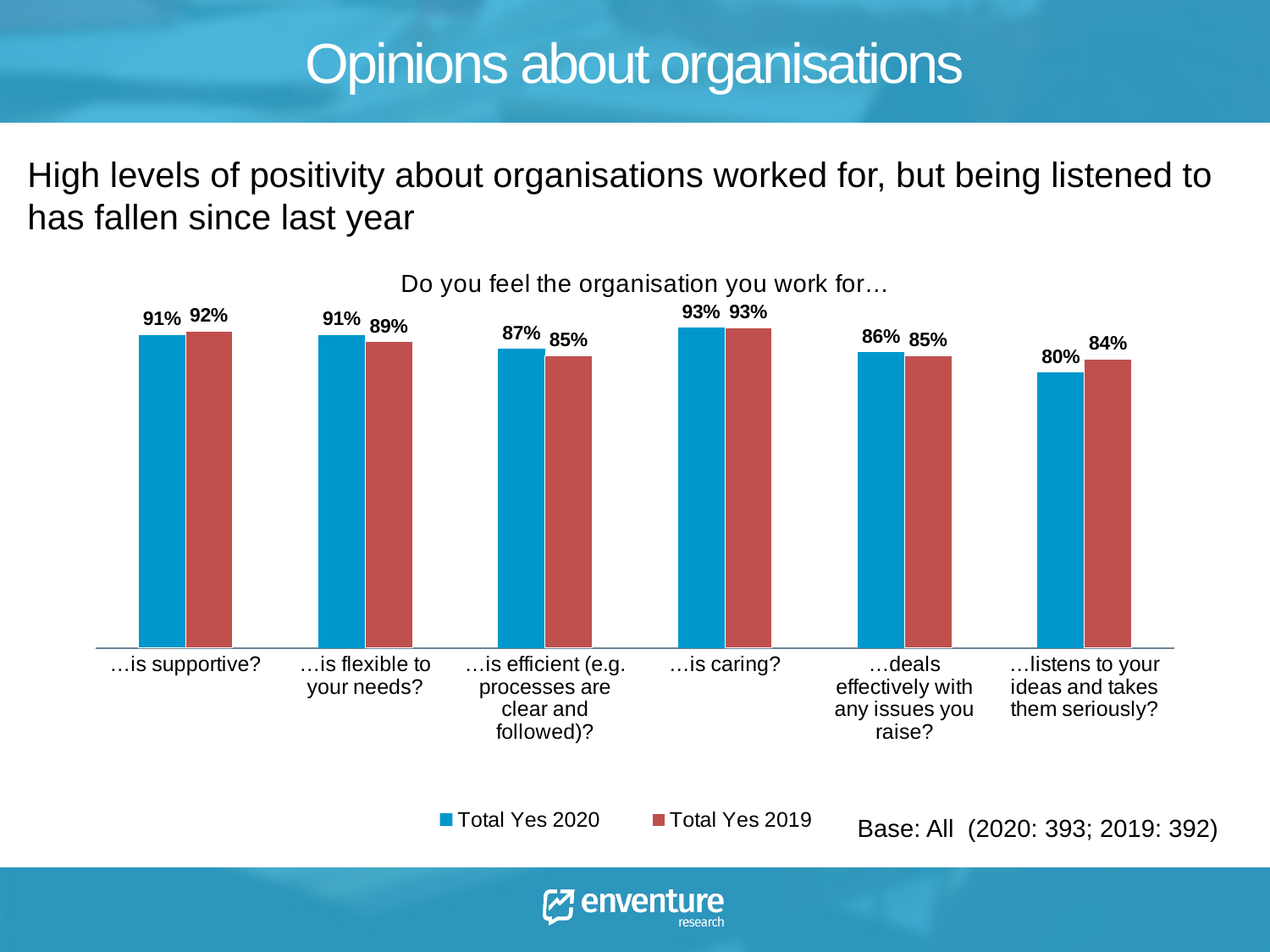
What is the Total Yes 2019 value for "…is flexible to your needs?"? 89% Which colour represents Total Yes 2019 in the chart? Red What is the title of the chart? Do you feel the organisation you work for… What is the difference between the Total Yes 2019 and Total Yes 2020 values for "…listens to your ideas and takes them seriously?"? 4% What is the Total Yes 2020 value for "…listens to your ideas and takes them seriously?"? 80% What is the Total Yes 2020 value for "…is supportive?"? 91% How many series does the legend list? 2 Which category has the highest Total Yes 2020 value? …is caring? For "…is efficient (e.g. processes are clear and followed)?", which is larger: Total Yes 2020 or Total Yes 2019? Total Yes 2020 Which category has the lowest Total Yes 2019 value? …listens to your ideas and takes them seriously? How many categories are shown on the x axis of the chart? 6 What kind of chart is shown on the slide? Bar chart